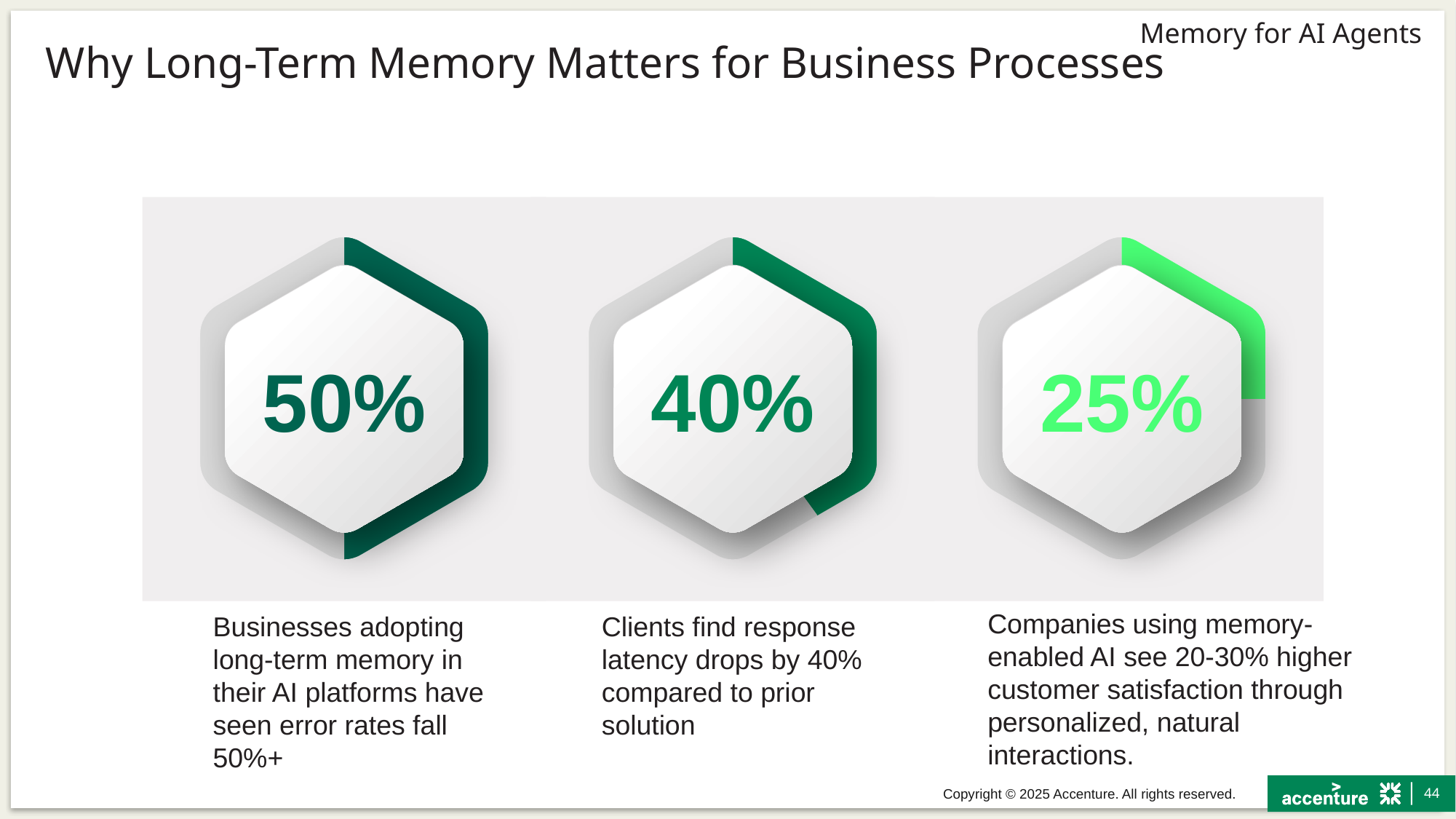
Do the percentages increase or decrease from the left hexagon to the right hexagon? Decrease What percentage is shown in the left hexagon, for businesses adopting long-term memory seeing error rates fall? 50% What is the difference between the percentage in the left hexagon and the percentage in the middle hexagon? 10% What kind of visual is used to display the three percentages? Hexagonal progress (gauge) indicators What percentage is shown in the middle hexagon, for the drop in response latency? 40% What percentage is shown in the right hexagon, for higher customer satisfaction with memory-enabled AI? 25% What is the difference between the percentage in the left hexagon and the percentage in the right hexagon? 25% What colour is the 25% value in the right hexagon? Bright green Which is larger: the percentage for response latency drop or the percentage for higher customer satisfaction? Response latency drop (40%) Which of the three hexagon indicators shows the lowest percentage? 25% (customer satisfaction) Which of the three hexagon indicators shows the highest percentage? 50% (error rates fall) How many hexagon percentage indicators are shown on the slide? 3